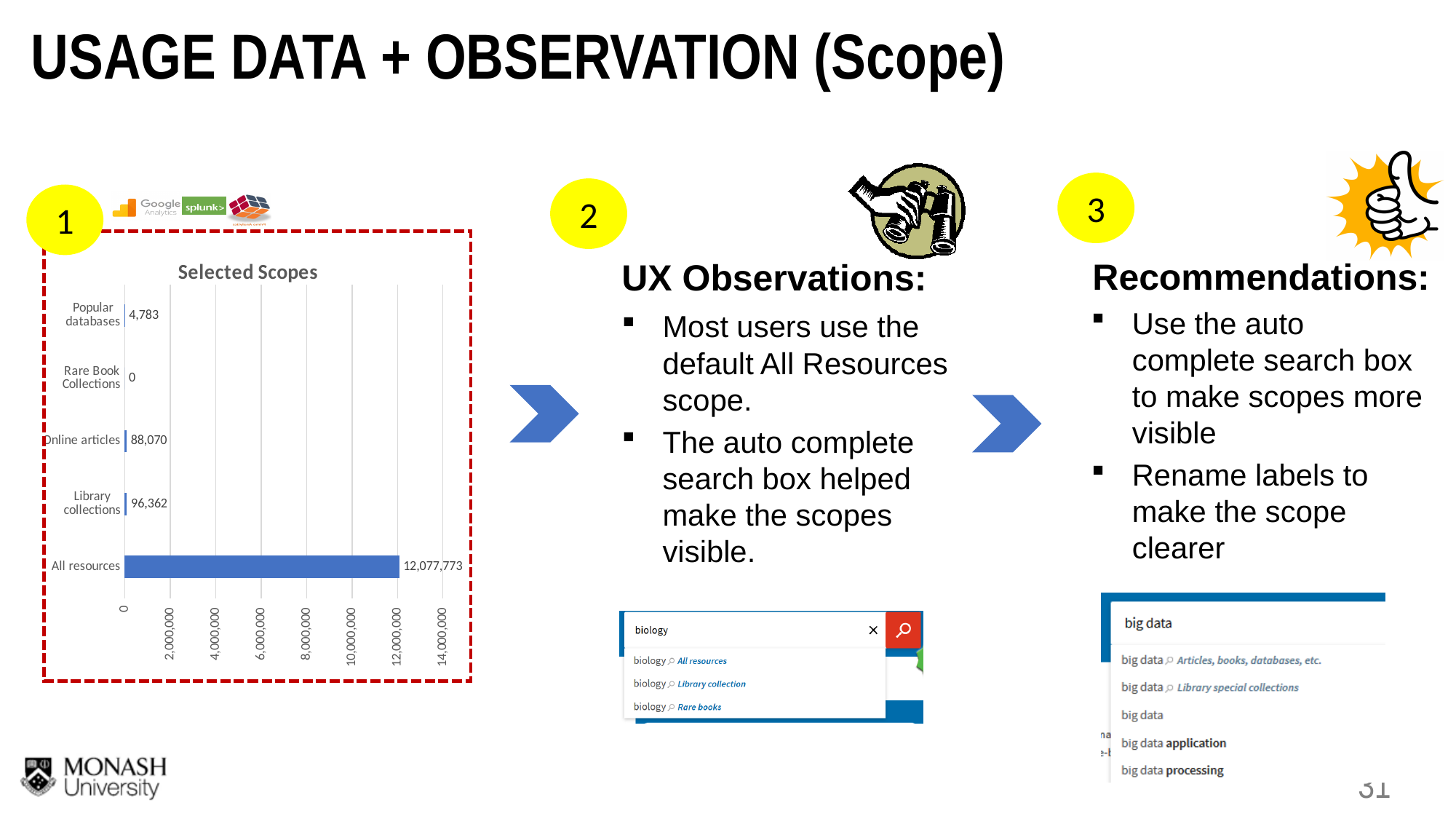
What is the value for Popular databases in the Selected Scopes chart? 4,783 Which category has the lowest value in the Selected Scopes chart? Rare Book Collections What is the value for Rare Book Collections in the Selected Scopes chart? 0 What is the difference between Library collections and Online articles in the Selected Scopes chart? 8,292 Is the value for All resources in the Selected Scopes chart greater or less than 10,000,000? greater How many categories are shown in the Selected Scopes chart? 5 What is the value for Online articles in the Selected Scopes chart? 88,070 What is the value for Library collections in the Selected Scopes chart? 96,362 Which is larger in the Selected Scopes chart, Popular databases or Online articles? Online articles What is the value for All resources in the Selected Scopes chart? 12,077,773 Which category has the highest value in the Selected Scopes chart? All resources What kind of chart is the Selected Scopes chart? bar chart